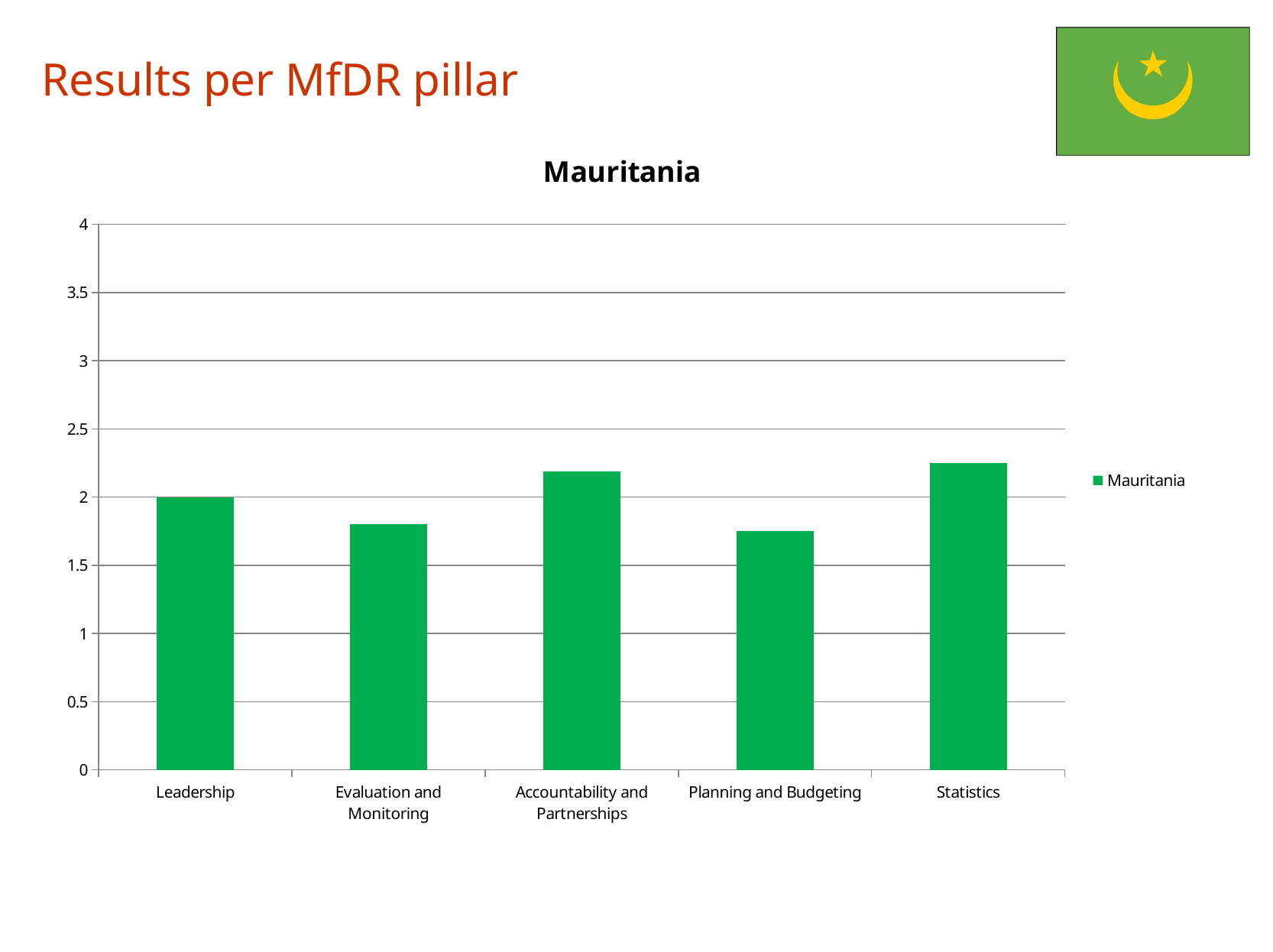
Which has the larger value, Leadership or Evaluation and Monitoring? Leadership How many categories (pillars) are shown on the x axis? 5 What colour are the bars in the chart? Green Is the value for Planning and Budgeting greater or less than 2? less How many series does the legend list? 1 Is the value for Statistics greater or less than 2.5? less What is the title of the chart? Mauritania Which has the larger value, Accountability and Partnerships or Planning and Budgeting? Accountability and Partnerships What type of chart is shown on the slide? Bar chart What is the value for Leadership? 2 Is the value for Evaluation and Monitoring greater or less than 2? less